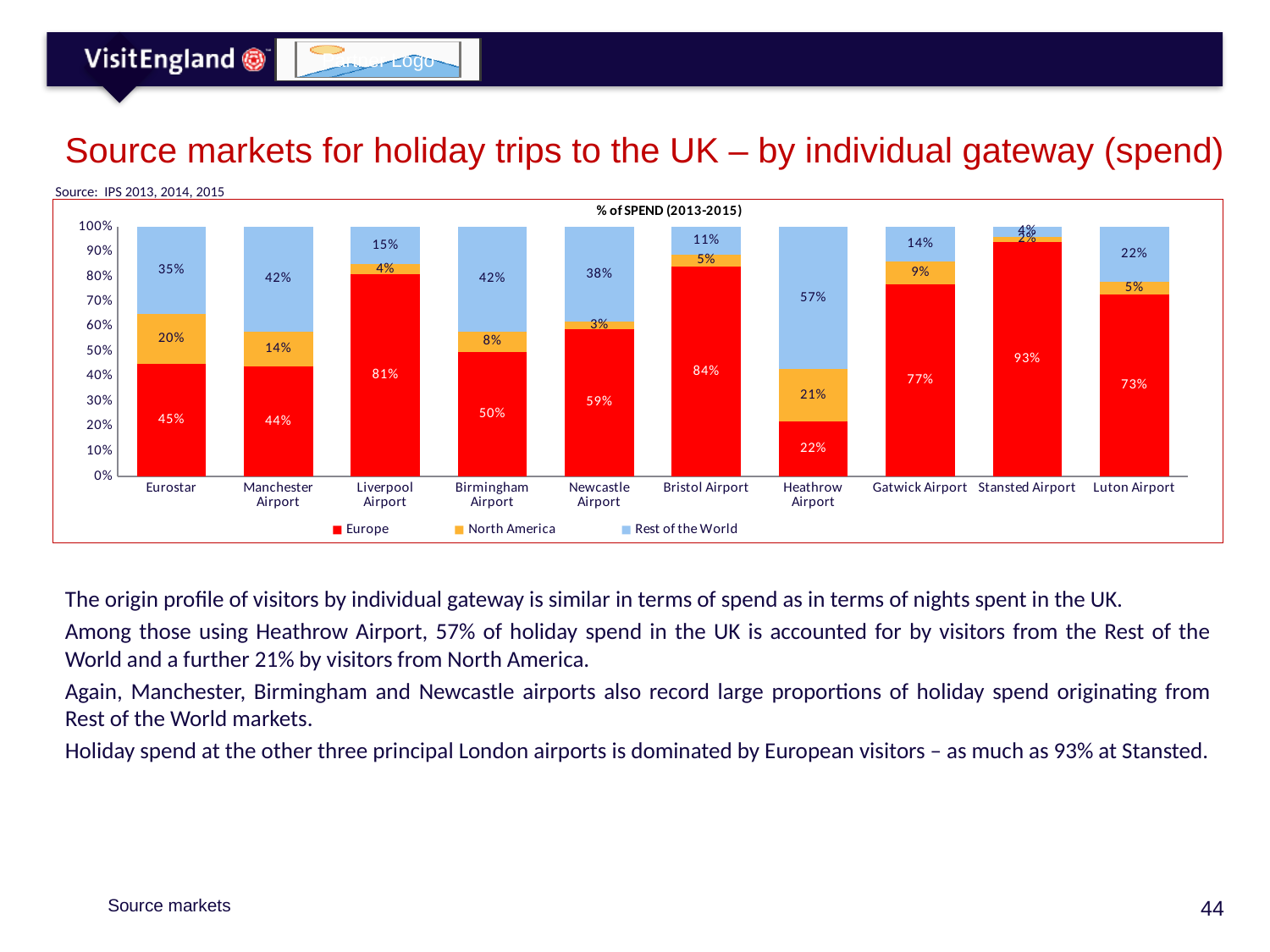
How many gateways are shown on the x axis of the chart? 10 Which gateway has the lowest Europe share of spend? Heathrow Airport What is the title of the chart? % of SPEND (2013-2015) What is the North America share of spend for Eurostar? 20% What is the difference between the Europe share at Bristol Airport and at Luton Airport? 11% How many series does the chart legend list? 3 What percentage of holiday spend at Heathrow Airport comes from the Rest of the World? 57% Which colour represents North America in the chart? Orange What type of chart is shown on the slide? Stacked bar chart What is the Europe share of spend for Stansted Airport? 93% Which has a larger Rest of the World share of spend, Manchester Airport or Newcastle Airport? Manchester Airport Which gateway has the highest Rest of the World share of spend? Heathrow Airport